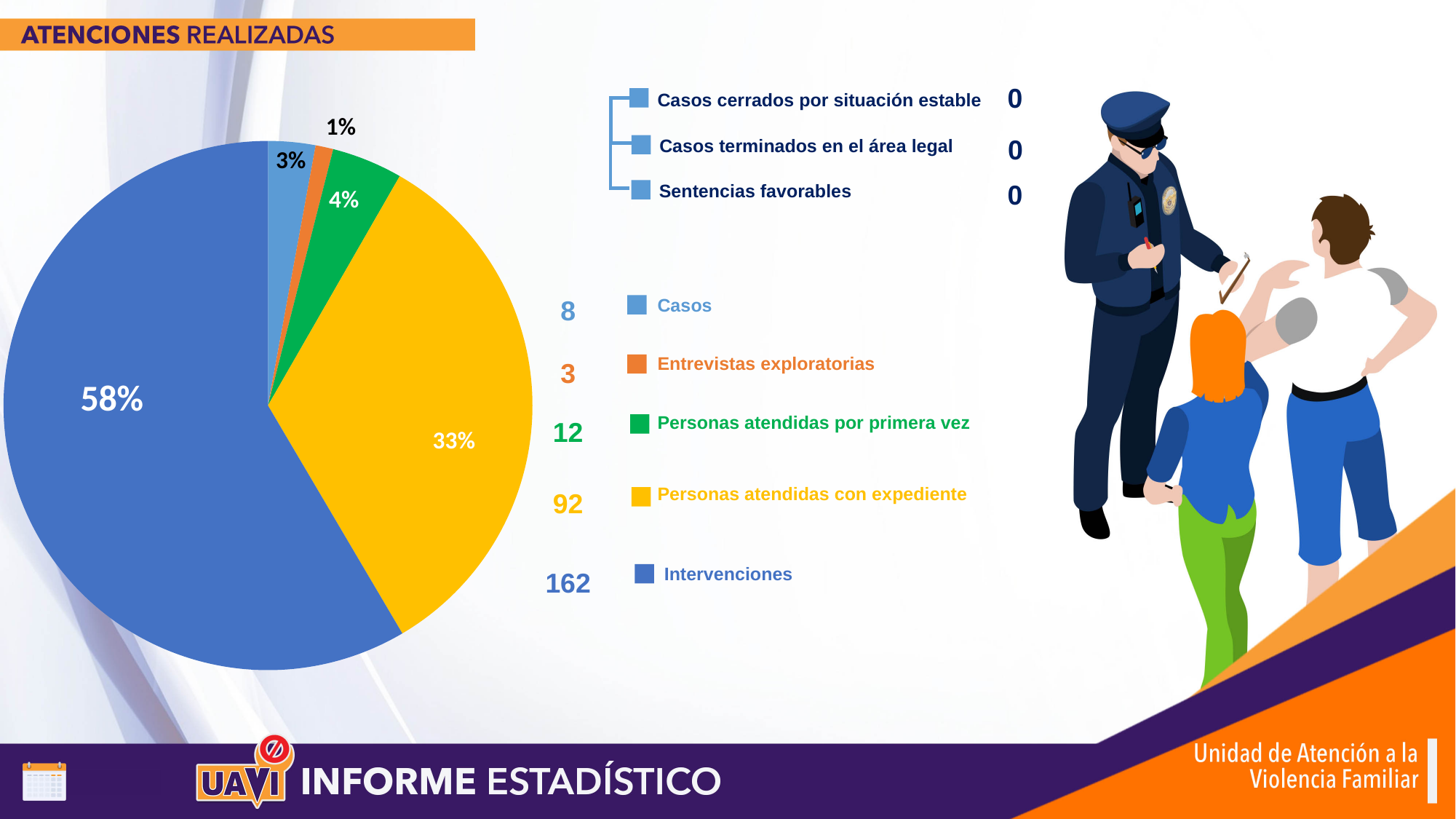
What is the difference in percentage points between the Intervenciones slice and the Personas atendidas con expediente slice? 25 How many slices does the pie chart have? 5 What percentage of the pie does Intervenciones represent? 58% Which category has the smallest slice of the pie? Entrevistas exploratorias What percentage of the pie does Casos represent? 3% Which category has the largest slice of the pie? Intervenciones What percentage of the pie does Entrevistas exploratorias represent? 1% What percentage of the pie does Personas atendidas por primera vez represent? 4% What kind of chart is shown on the slide? pie chart What count is shown in the legend for Intervenciones? 162 Which slice is larger, Casos or Personas atendidas por primera vez? Personas atendidas por primera vez What percentage of the pie does Personas atendidas con expediente represent? 33%